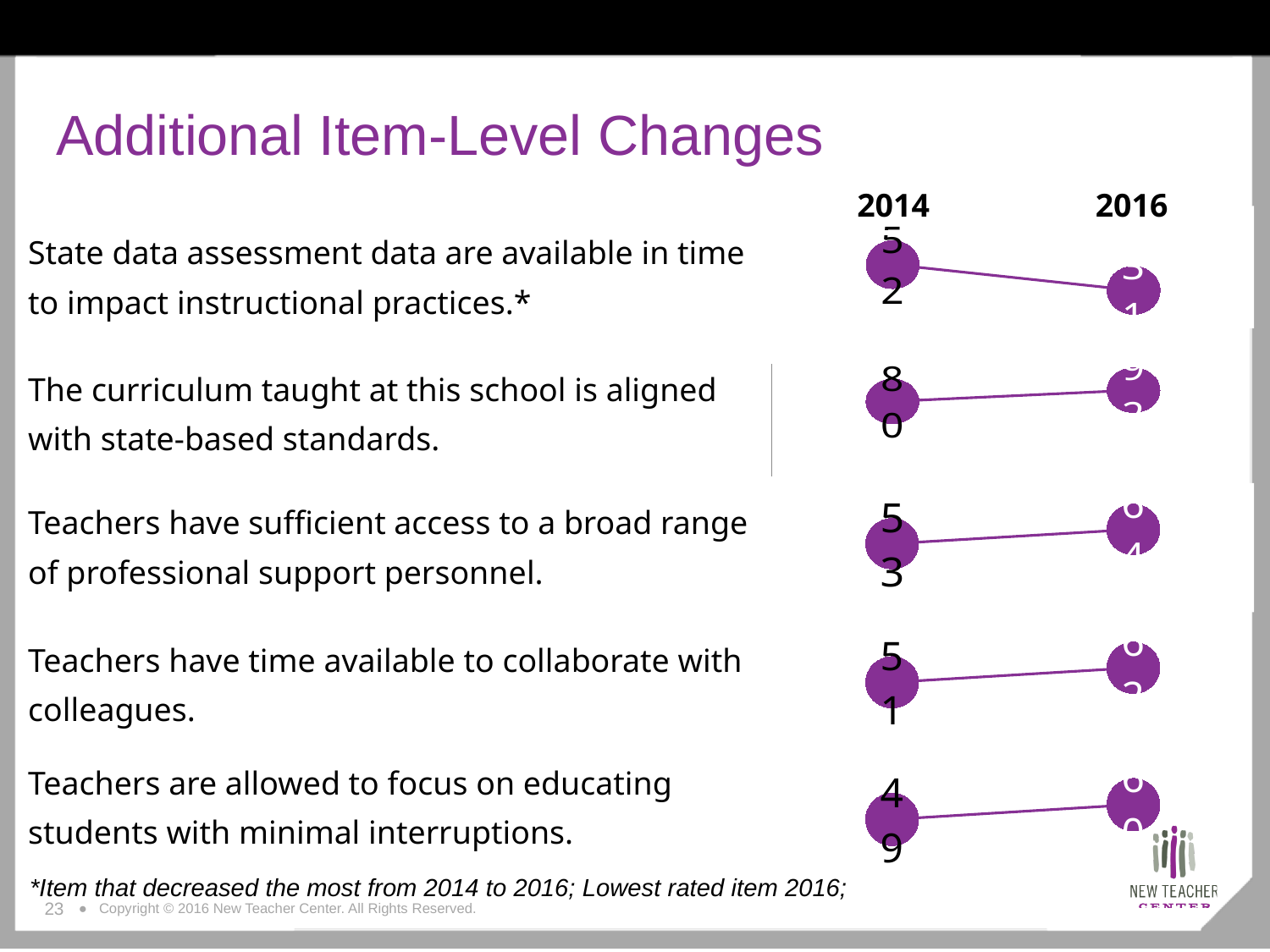
How many data points does each chart on the slide plot? 2 In the chart next to "Teachers are allowed to focus on educating students with minimal interruptions," what is the value for 2014? 49 In the chart next to "Teachers have time available to collaborate with colleagues," which year has the larger value, 2014 or 2016? 2016 In the chart next to "The curriculum taught at this school is aligned with state-based standards," does the value rise or fall from 2014 to 2016? rise In the chart next to "State data assessment data are available in time to impact instructional practices," does the value rise or fall from 2014 to 2016? fall Among the 2014 values shown in the five charts, which item has the lowest value? Teachers are allowed to focus on educating students with minimal interruptions. In the chart next to "State data assessment data are available in time to impact instructional practices," what is the value for 2014? 52 In the chart next to "Teachers have sufficient access to a broad range of professional support personnel," what is the value for 2014? 53 Among the 2014 values shown in the five charts, which item has the highest value? The curriculum taught at this school is aligned with state-based standards. What kind of chart is used on the right side of the slide? line chart In the chart next to "The curriculum taught at this school is aligned with state-based standards," what is the value for 2014? 80 In the chart next to "Teachers have time available to collaborate with colleagues," what is the value for 2014? 51